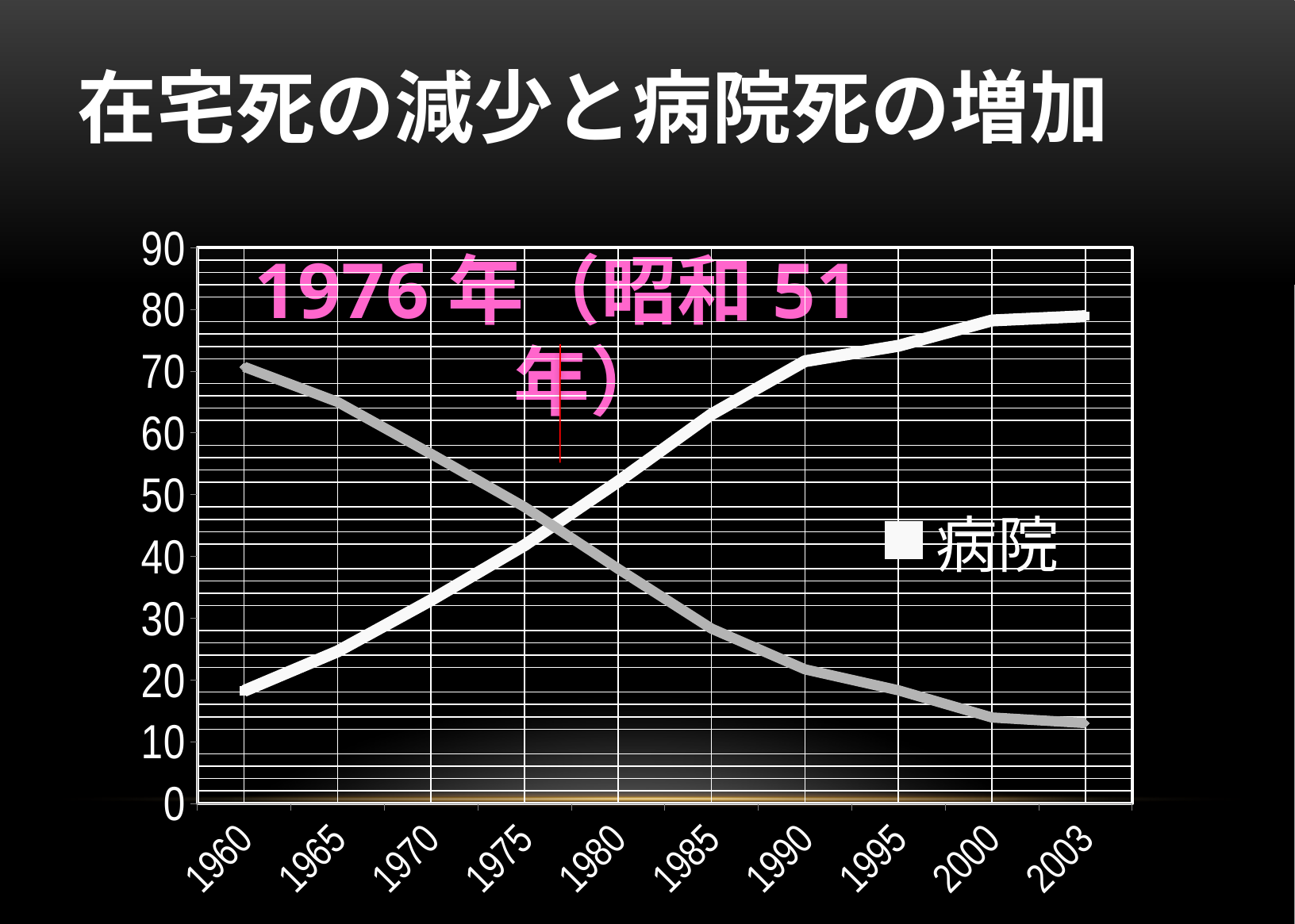
What is the name of the series listed in the legend? 病院 In 2003, which line has the higher value, the 病院 line or the grey line? 病院 Is the value of the 病院 line in 2003 greater or less than 70? greater Does the 病院 line rise or fall from 1960 to 2003? rise What kind of chart is shown on the slide? line chart Is the value of the grey line in 1960 greater or less than 60? greater What is the title of the slide above the chart? 在宅死の減少と病院死の増加 Does the grey line rise or fall from 1960 to 2003? fall Is the value of the 病院 line in 1960 greater or less than 20? less How many years are labelled along the x axis of the chart? 10 How many series does the chart's legend list? 1